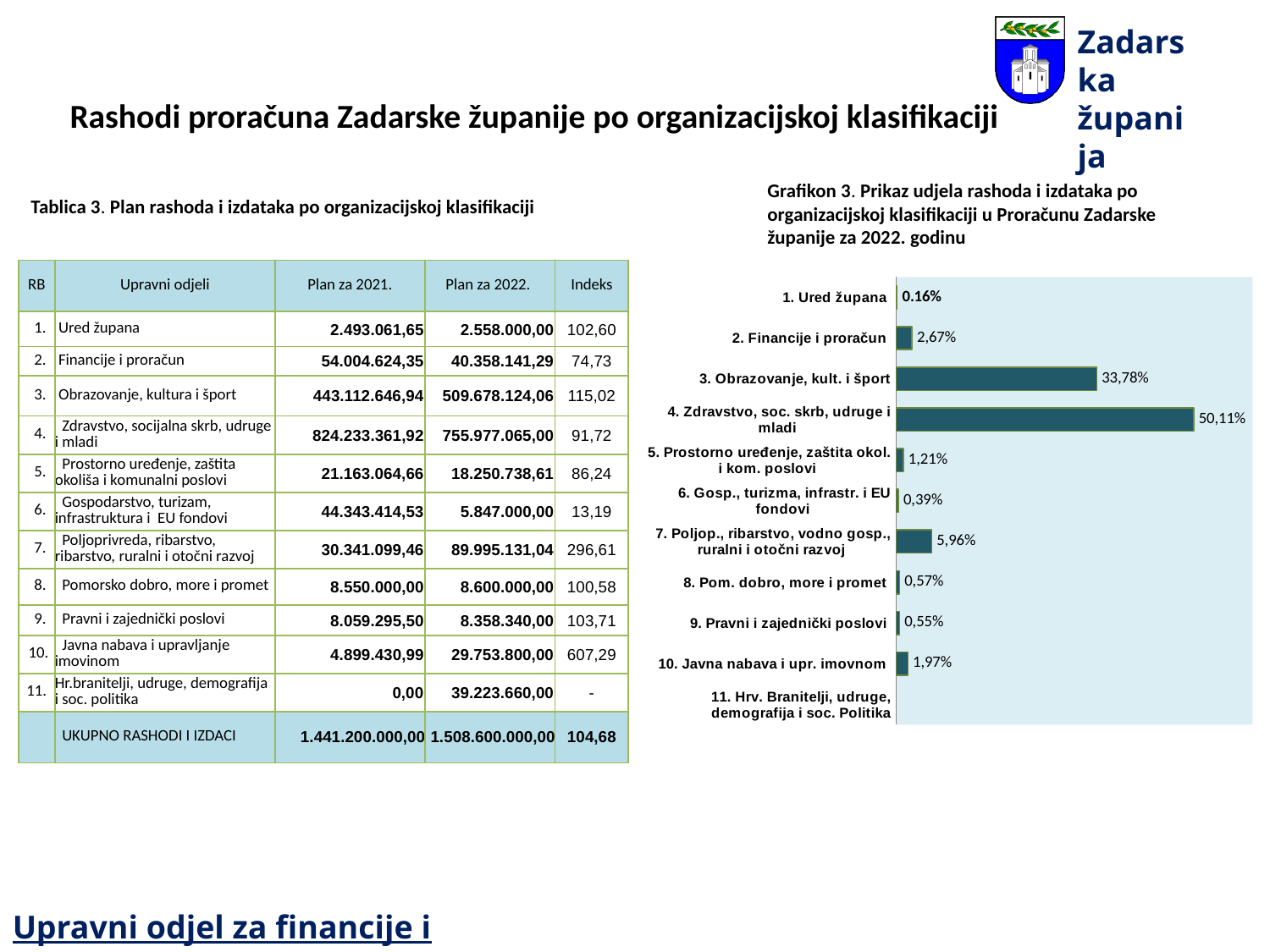
In Grafikon 3, what is the value shown for '10. Javna nabava i upr. imovnom'? 1,97% In Grafikon 3, what is the value shown for '4. Zdravstvo, soc. skrb, udruge i mladi'? 50,11% In Grafikon 3, what is the value shown for '6. Gosp., turizma, infrastr. i EU fondovi'? 0,39% In Grafikon 3, what is the value shown for '7. Poljop., ribarstvo, vodno gosp., ruralni i otočni razvoj'? 5,96% In Grafikon 3, what is the value shown for '2. Financije i proračun'? 2,67% In Grafikon 3, what is the difference between the shares of '4. Zdravstvo, soc. skrb, udruge i mladi' and '3. Obrazovanje, kult. i šport'? 16,33% What is the title of the chart on the slide? Grafikon 3. Prikaz udjela rashoda i izdataka po organizacijskoj klasifikaciji u Proračunu Zadarske županije za 2022. godinu In Grafikon 3, what is the value shown for '3. Obrazovanje, kult. i šport'? 33,78% In Grafikon 3, which category has the highest share? 4. Zdravstvo, soc. skrb, udruge i mladi In Grafikon 3, which category has the larger share: '2. Financije i proračun' or '7. Poljop., ribarstvo, vodno gosp., ruralni i otočni razvoj'? 7. Poljop., ribarstvo, vodno gosp., ruralni i otočni razvoj What type of chart is Grafikon 3 on the slide? bar chart How many categories are listed on the vertical axis of Grafikon 3? 11